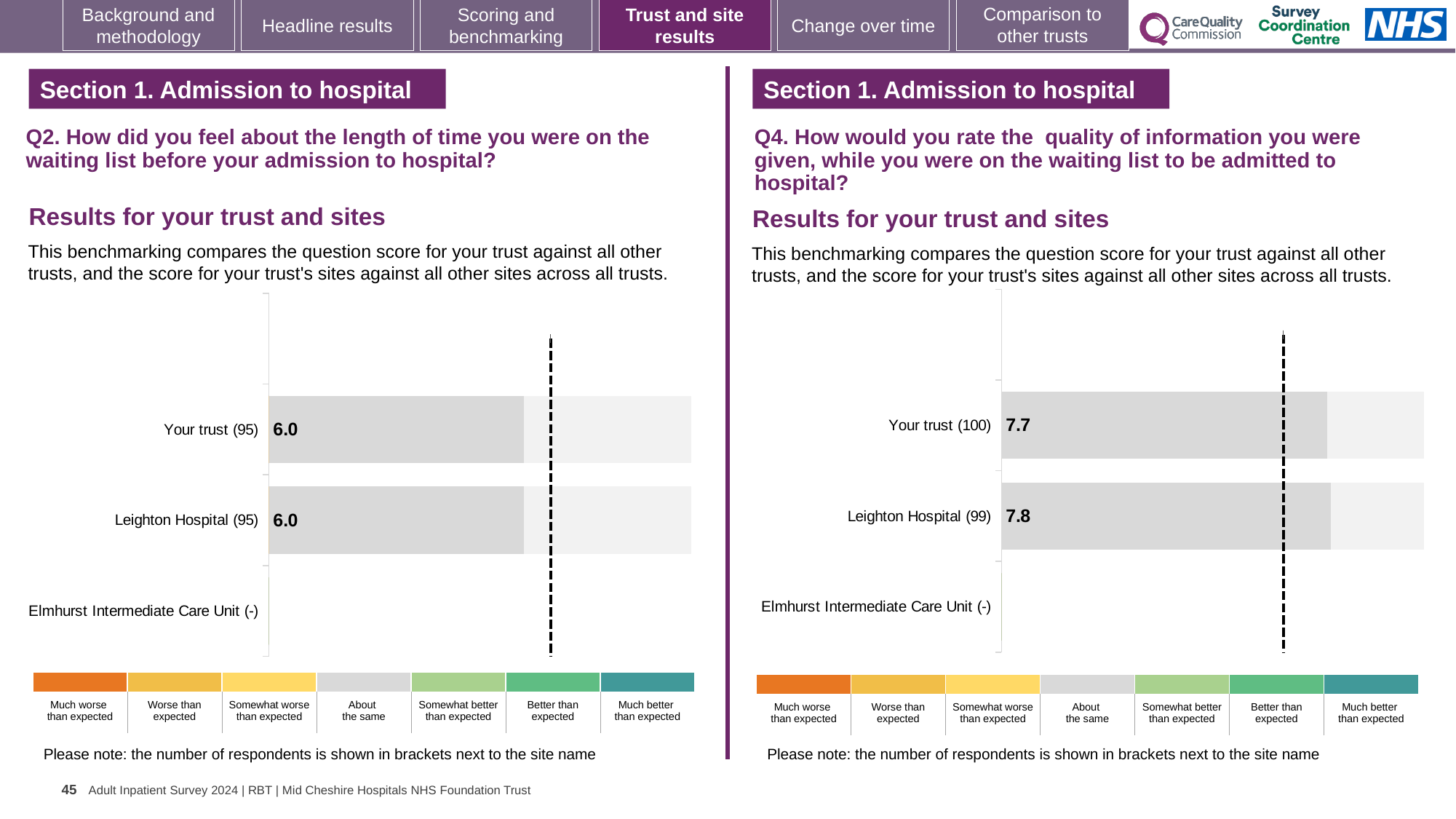
On the right chart (Q4), which has the higher score, Your trust or Leighton Hospital? Leighton Hospital On the left chart (Q2), what is the score for Your trust? 6.0 On the right chart (Q4), what is the score for Your trust? 7.7 On the right chart (Q4), what is the difference between the Leighton Hospital score and the Your trust score? 0.1 How many categories (sites) are listed on the left chart (Q2)? 3 On the left chart (Q2), how many respondents are shown in brackets for Your trust? 95 On the right chart (Q4), how many respondents are shown in brackets for Leighton Hospital? 99 On the left chart (Q2), what is the difference between the Your trust score and the Leighton Hospital score? 0.0 On the left chart (Q2), what is the score for Leighton Hospital? 6.0 On the right chart (Q4), what is the score for Leighton Hospital? 7.8 On the right chart (Q4), which site has no score shown? Elmhurst Intermediate Care Unit What kind of chart is used on the right (Q4)? Bar chart